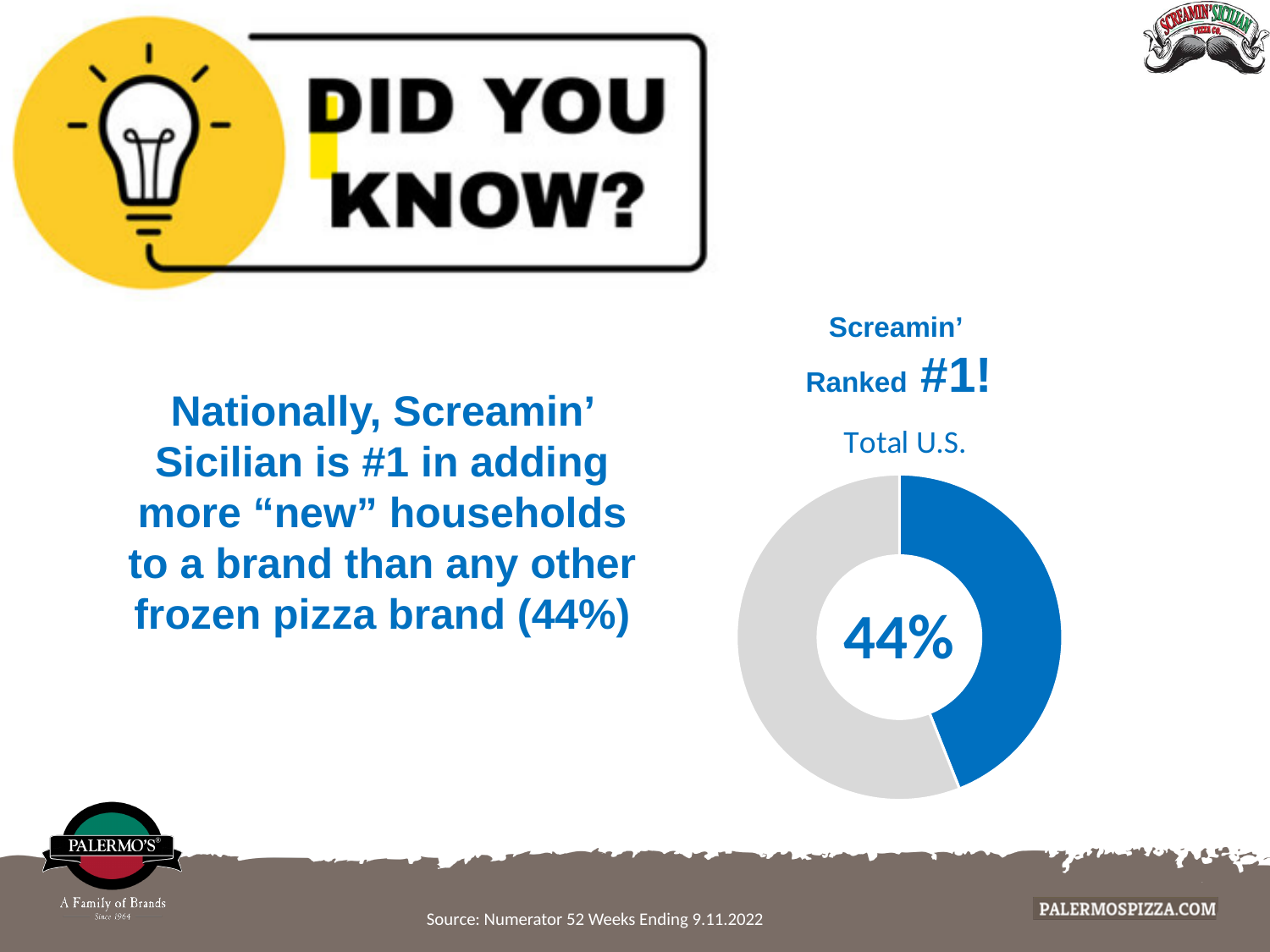
According to the slide, what percentage of new households did Screamin' Sicilian add nationally? 44% What kind of chart is shown on the slide? Donut chart What colour is the slice labelled 44% in the donut chart? Blue Which slice of the donut chart is larger, the blue slice or the grey slice? The grey slice How many slices does the donut chart have? 2 What share of the donut chart does the blue slice represent? 44% What value is printed in the center of the donut chart? 44% What is the title of the donut chart? Total U.S.